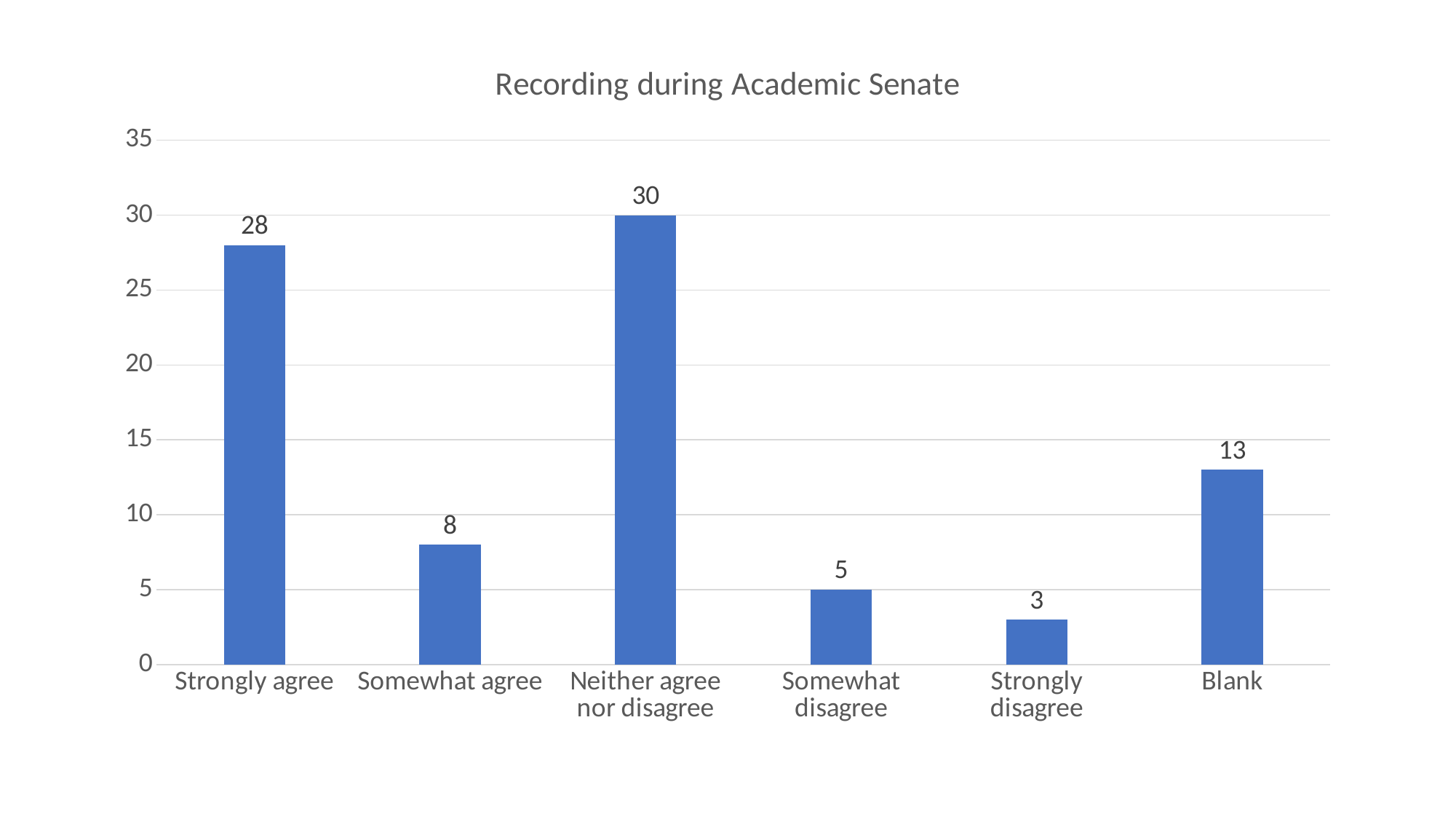
What kind of chart is this? Bar chart What is the value for Strongly agree? 28 Which category has the highest value? Neither agree nor disagree What is the value for Strongly disagree? 3 How many categories are shown on the x axis? 6 Which is larger, the value for Somewhat agree or the value for Somewhat disagree? Somewhat agree Which category has the lowest value? Strongly disagree What is the difference between the values for Blank and Somewhat agree? 5 What is the difference between the values for Neither agree nor disagree and Strongly agree? 2 What is the title of the chart? Recording during Academic Senate What is the value for Neither agree nor disagree? 30 What is the value for Blank? 13